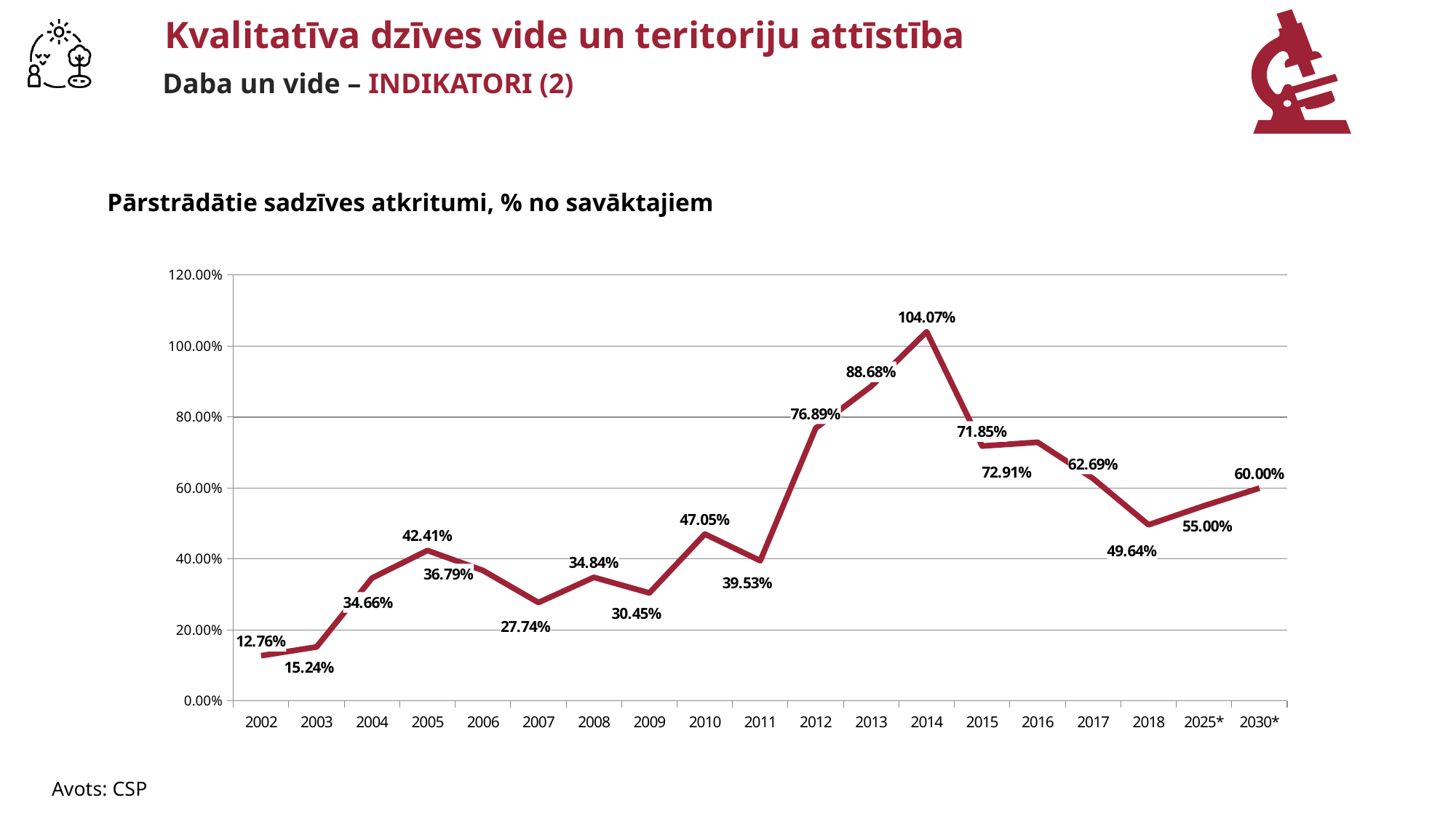
Is the value for 2013 greater or less than 80.00%? greater What is the value for 2014? 104.07% What is the value for 2030*? 60.00% Which year has the highest value? 2014 What is the difference between the values for 2014 and 2015? 32.22% What is the value for 2002? 12.76% What is the value for 2010? 47.05% Which is larger, the value for 2005 or the value for 2008? 2005 What is the title of the chart? Pārstrādātie sadzīves atkritumi, % no savāktajiem What type of chart is shown on the slide? line chart Which year has the lowest value? 2002 How many data points are plotted on the chart? 19